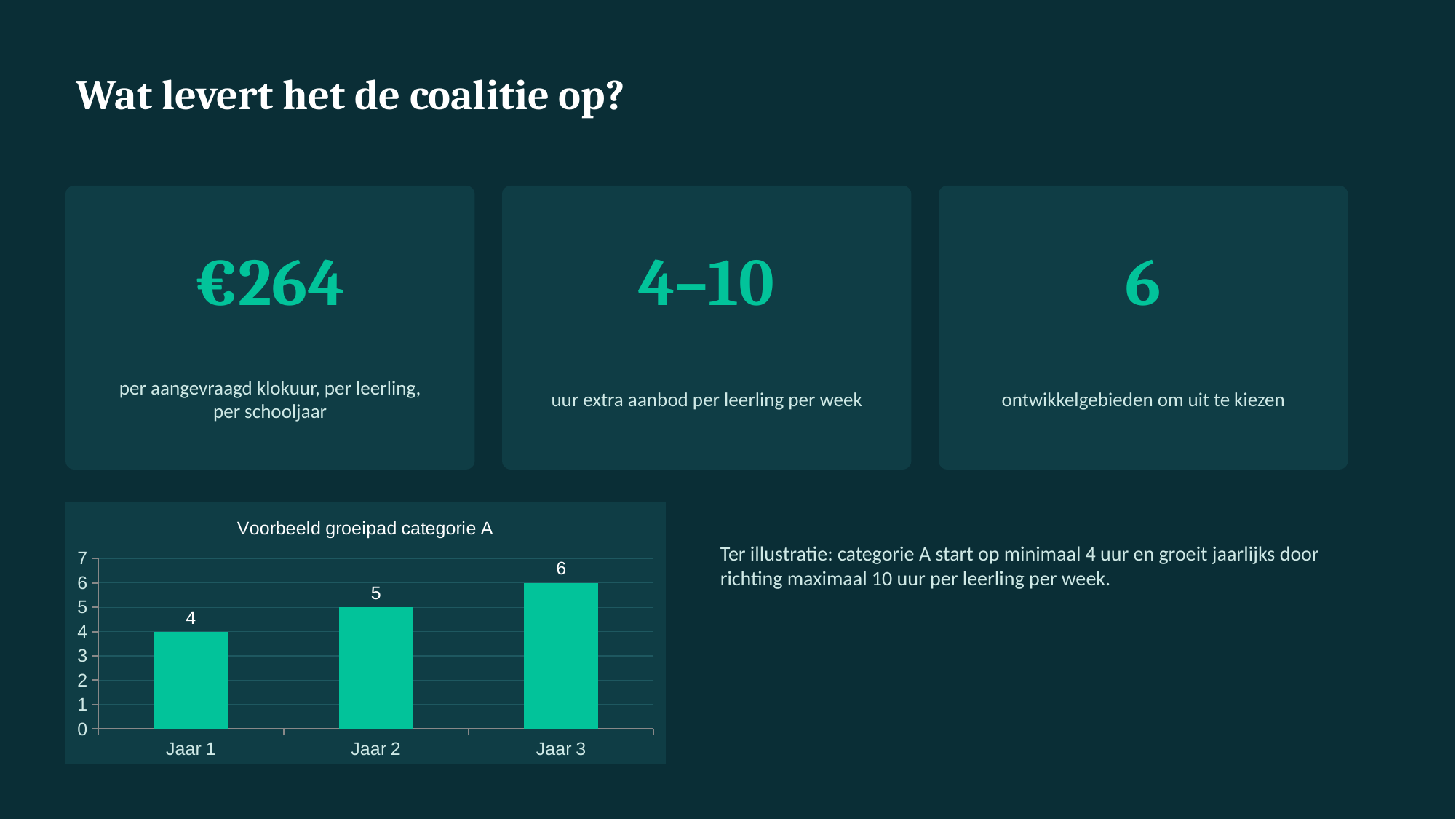
Do the values rise or fall from Jaar 1 to Jaar 3? Rise Which category has the lowest value in the chart? Jaar 1 Which is larger, the value for Jaar 2 or the value for Jaar 1? Jaar 2 What is the value for Jaar 3 in the chart? 6 What is the value for Jaar 2 in the chart? 5 What is the highest value shown on the y axis of the chart? 7 What is the value for Jaar 1 in the chart? 4 What is the difference between the values for Jaar 3 and Jaar 1? 2 How many categories are shown on the x axis of the chart? 3 What is the title of the chart? Voorbeeld groeipad categorie A What kind of chart is shown on the slide? Bar chart Which category has the highest value in the chart? Jaar 3